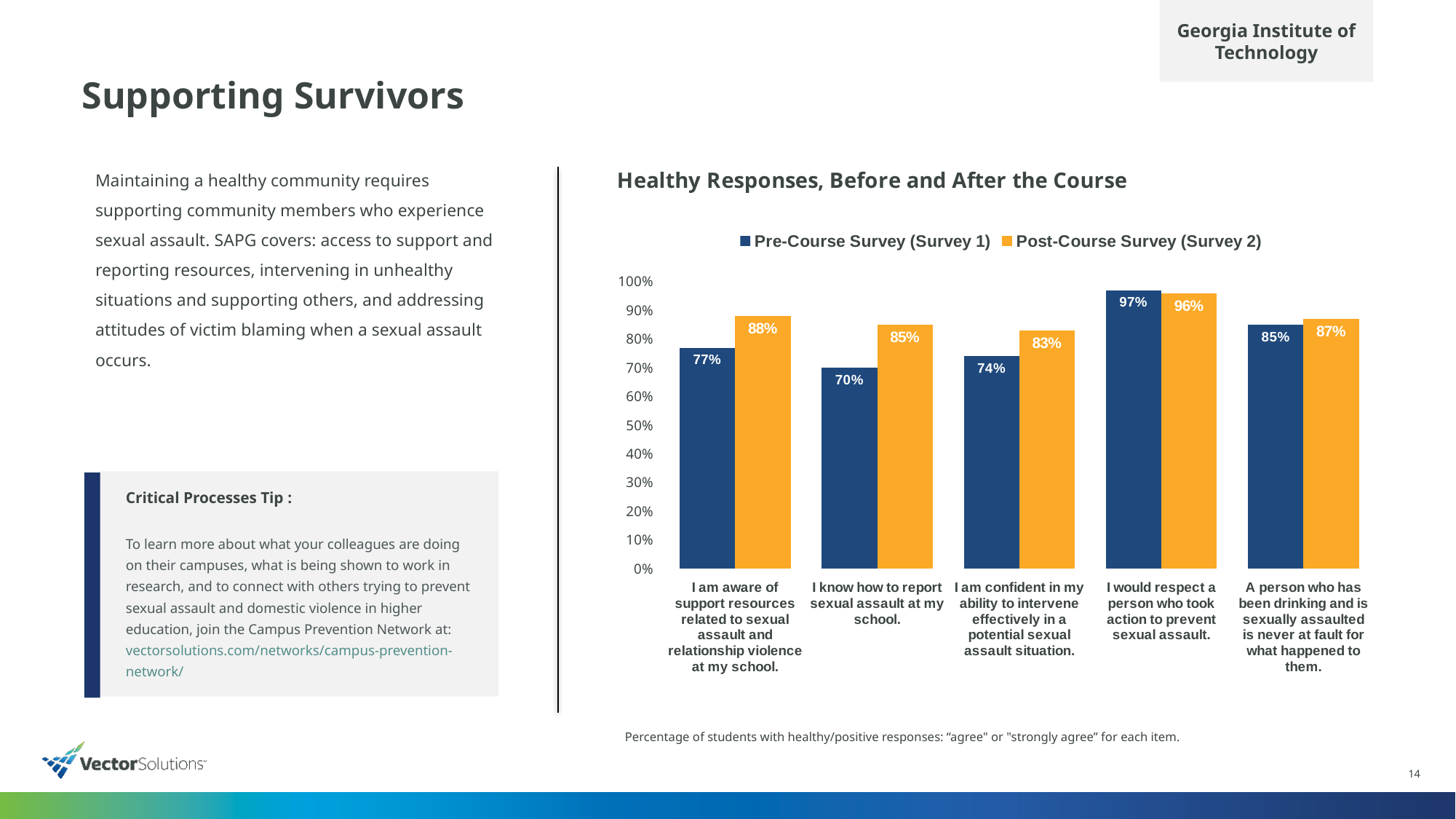
How many categories are shown on the x axis of the chart? 5 Which category has the lowest Post-Course Survey (Survey 2) value? I am confident in my ability to intervene effectively in a potential sexual assault situation. Which category has the highest Pre-Course Survey (Survey 1) value? I would respect a person who took action to prevent sexual assault. What is the title of the chart? Healthy Responses, Before and After the Course What kind of chart is shown on the slide? Bar chart Is the Pre-Course Survey (Survey 1) value for "I am confident in my ability to intervene effectively in a potential sexual assault situation." greater or less than 80%? less How many series does the chart legend list? 2 For "I would respect a person who took action to prevent sexual assault.", which is larger: the Pre-Course Survey value or the Post-Course Survey value? Pre-Course Survey (Survey 1) What is the Pre-Course Survey (Survey 1) value for "I know how to report sexual assault at my school."? 70% What is the Post-Course Survey (Survey 2) value for "I am aware of support resources related to sexual assault and relationship violence at my school."? 88% What is the difference between the Post-Course and Pre-Course Survey values for "I know how to report sexual assault at my school."? 15% What is the Post-Course Survey (Survey 2) value for "I am confident in my ability to intervene effectively in a potential sexual assault situation."? 83%